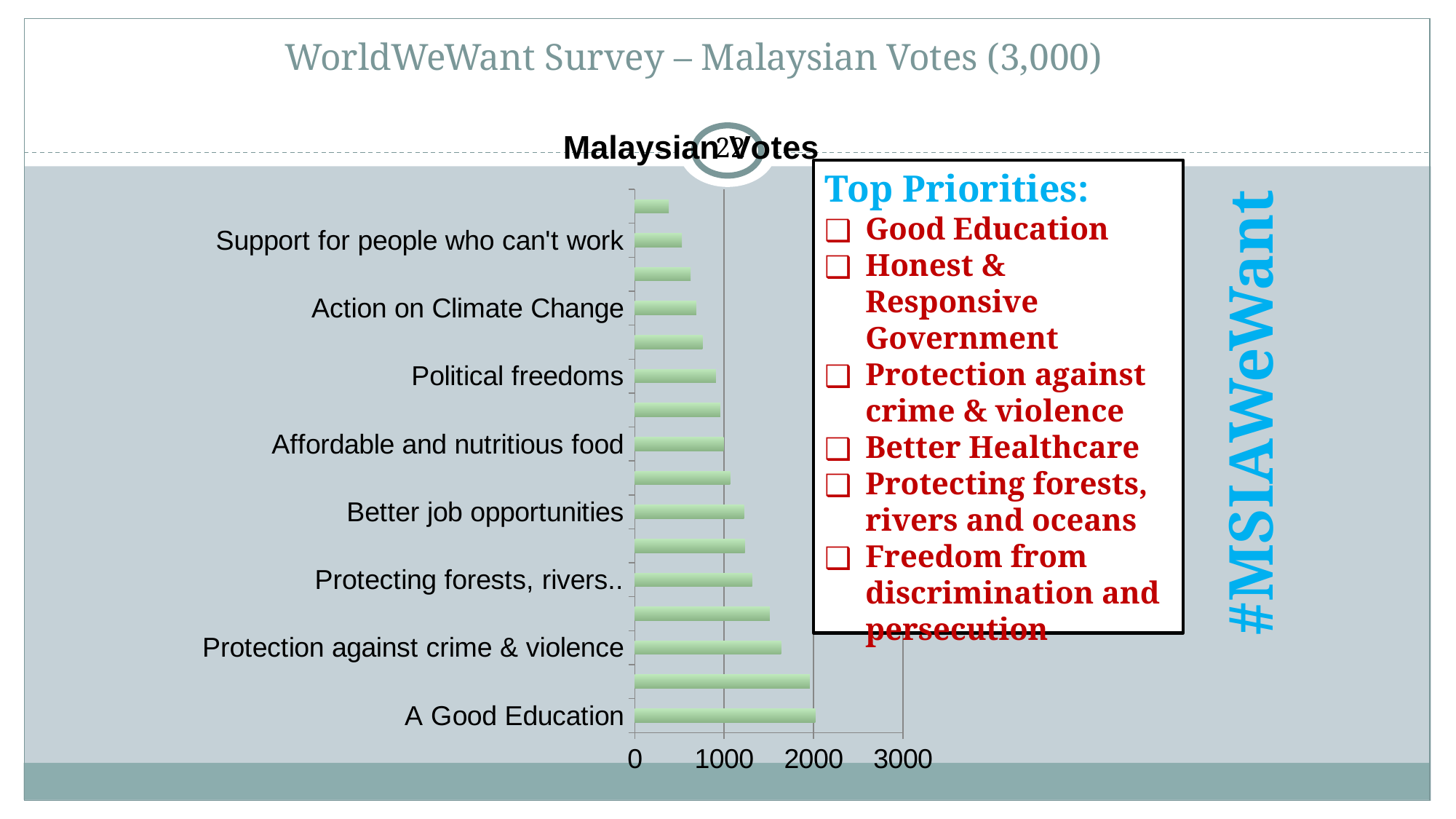
Which has more votes, Protection against crime & violence or Action on Climate Change? Protection against crime & violence What is the highest value shown on the horizontal axis? 3000 Is the value for Protection against crime & violence greater or less than 2000? less Is the value for Protection against crime & violence greater or less than 1000? greater Is the value for Better job opportunities greater or less than 1000? greater Which labelled category has the highest number of votes? A Good Education What kind of chart is shown on the slide? bar chart What is the title of the chart? Malaysian Votes Which has more votes, A Good Education or Support for people who can't work? A Good Education